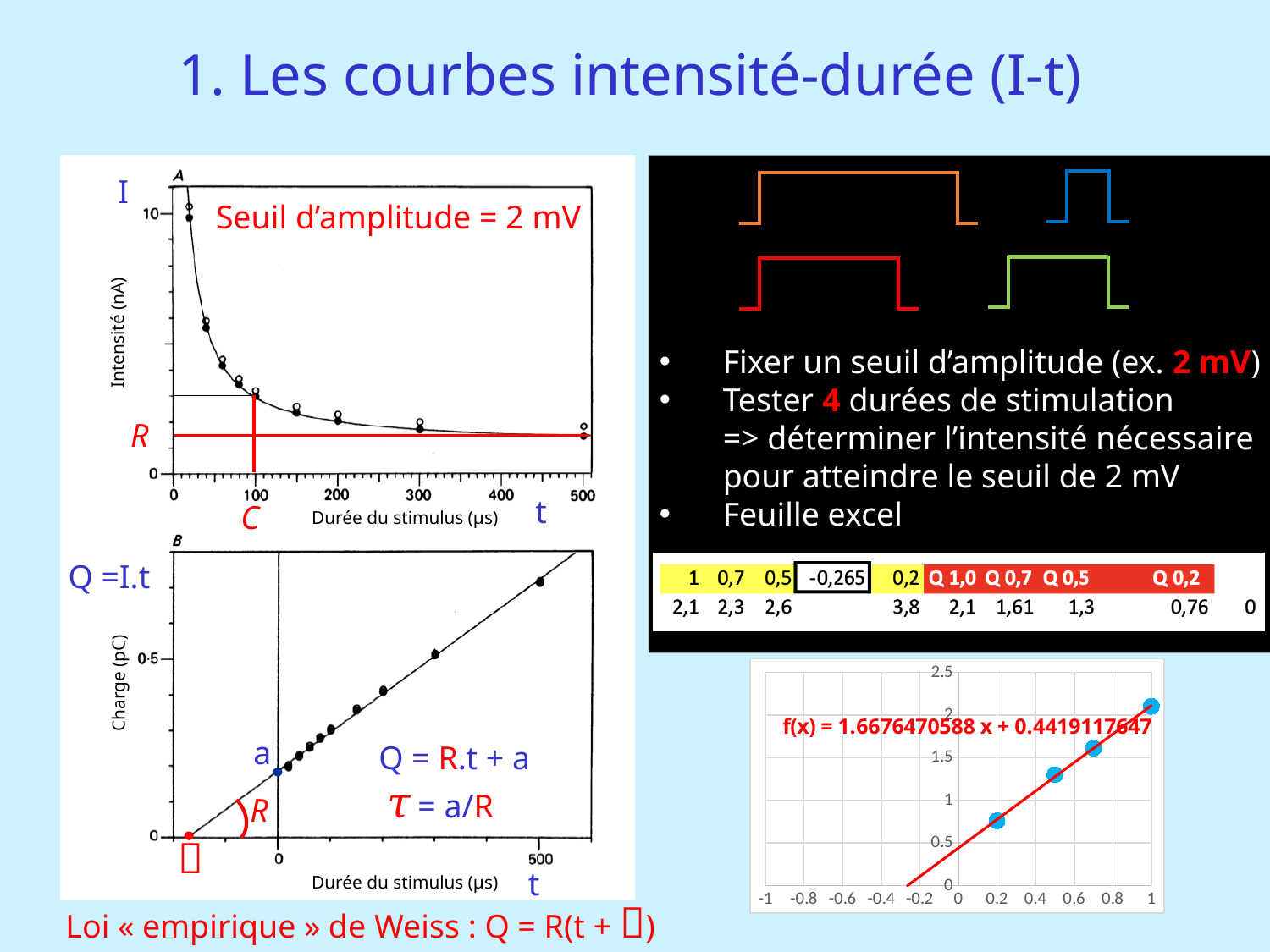
In the Excel scatter chart at the bottom right, at which x value is the highest plotted point? 1 How many data points are plotted in the Excel scatter chart at the bottom right? 4 What is the y-axis label of chart B at the bottom left? Charge (pC) In the Excel scatter chart at the bottom right, do the values rise or fall as x increases? rise In chart B at the bottom left (Charge vs Durée du stimulus), does the charge rise or fall as the stimulus duration increases? rise In chart A at the top left (Intensité vs Durée du stimulus), does the intensity rise or fall as the stimulus duration increases? fall In the Excel scatter chart at the bottom right, is the value of the point at x = 0.2 greater or less than 1? less In the Excel scatter chart at the bottom right, what is the highest tick value shown on the y axis? 2.5 In chart A at the top left, is the intensity at a stimulus duration of 100 µs greater or less than 10 nA? less What is the trendline equation shown on the Excel scatter chart at the bottom right? f(x) = 1.6676470588 x + 0.4419117647 In the Excel scatter chart at the bottom right, is the value of the point at x = 0.5 greater or less than 1? greater What kind of chart is the Excel chart at the bottom right of the slide? scatter chart